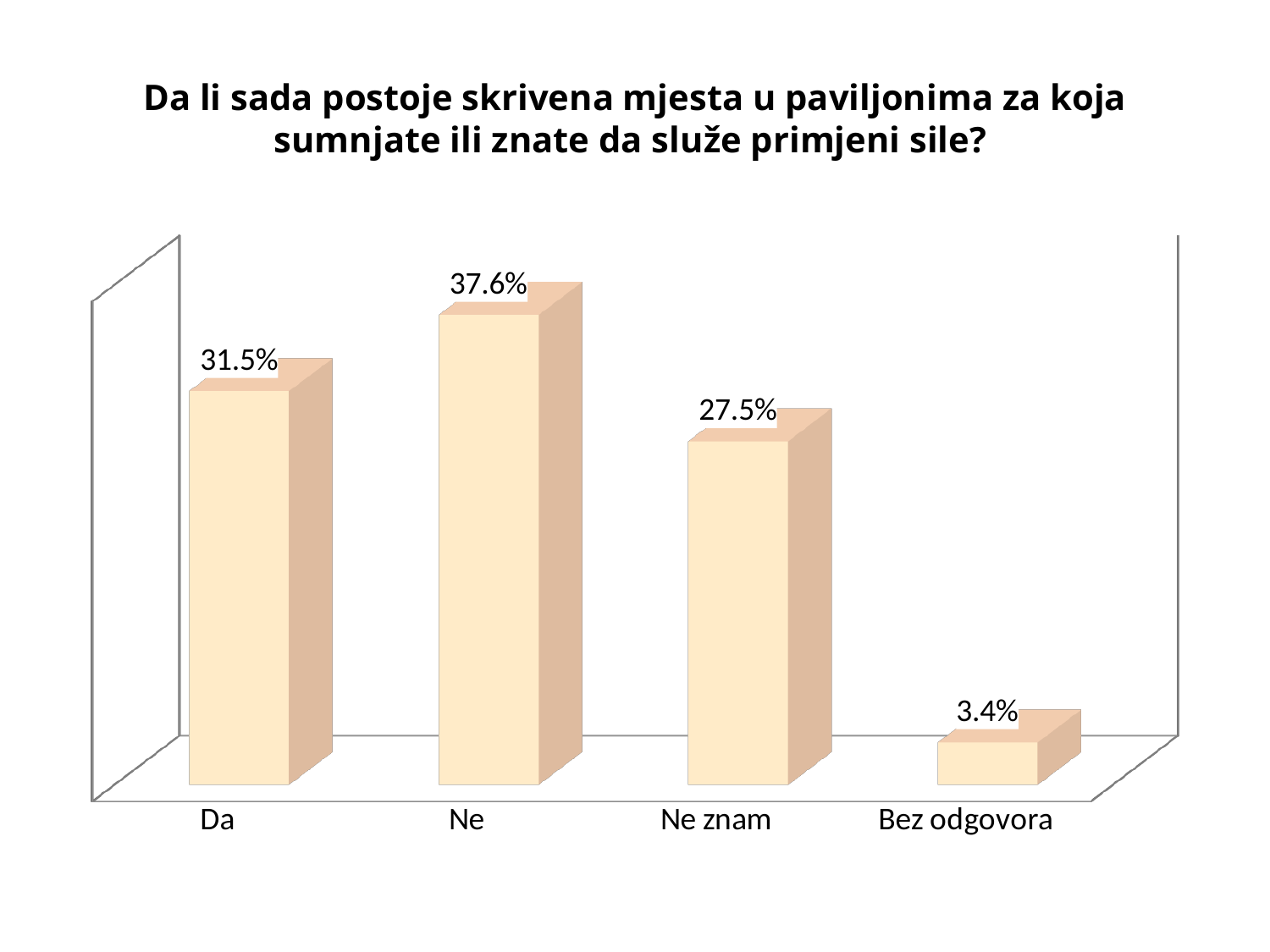
What is the difference between the values for "Da" and "Ne znam"? 4.0% Which category has the lowest value? Bez odgovora What is the value for "Bez odgovora"? 3.4% Which is larger, the value for "Da" or the value for "Ne znam"? Da What is the title of the chart? Da li sada postoje skrivena mjesta u paviljonima za koja sumnjate ili znate da služe primjeni sile? What is the value for "Da"? 31.5% What kind of chart is shown on the slide? Bar chart What is the value for "Ne"? 37.6% Which category has the highest value? Ne What is the difference between the values for "Ne" and "Da"? 6.1% What is the value for "Ne znam"? 27.5% How many categories are shown on the x axis? 4